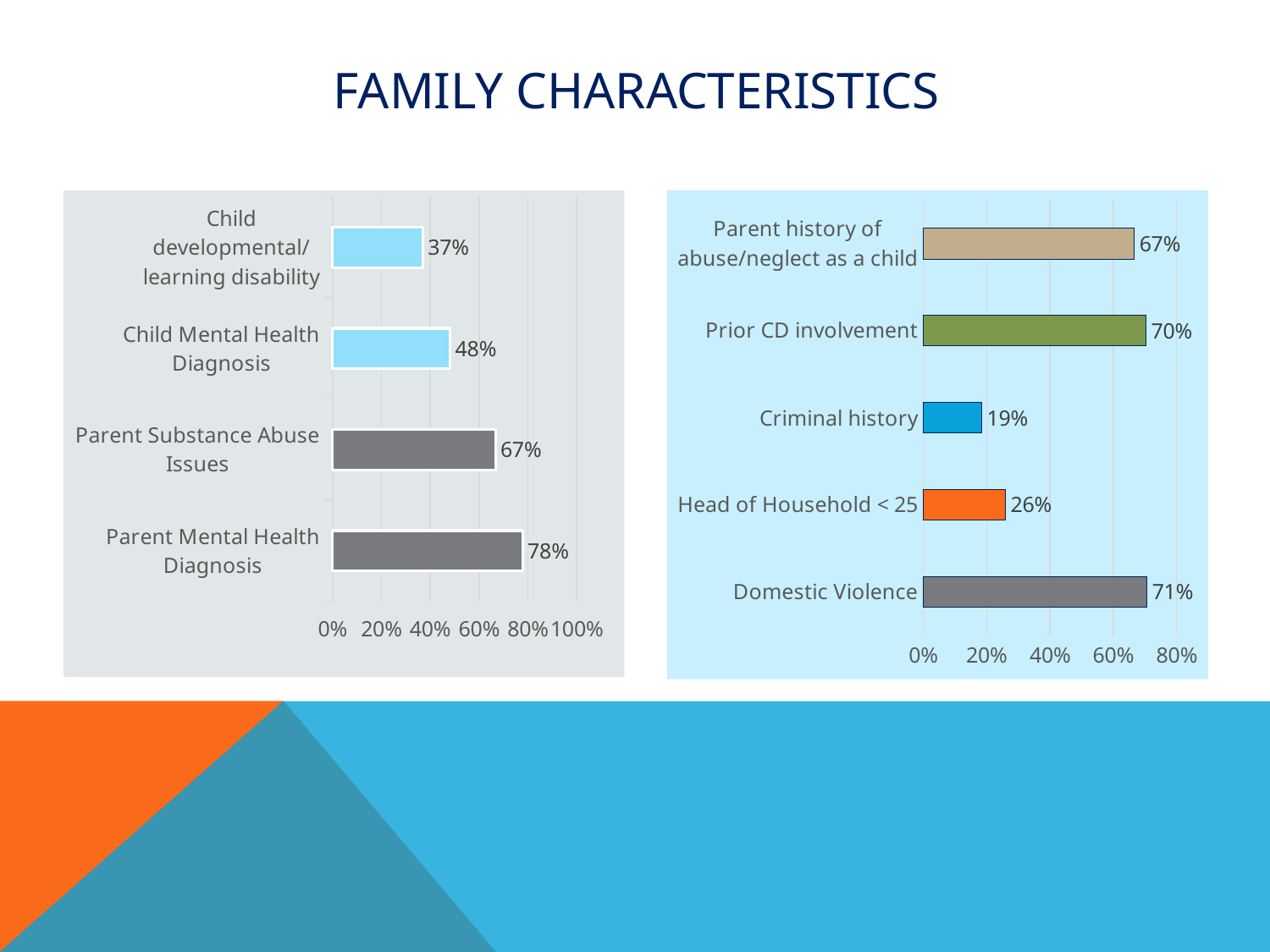
In the right chart, which category has the lowest value? Criminal history In the left chart, which category has the lowest value? Child developmental/learning disability In the left chart, what is the value for Child Mental Health Diagnosis? 48% What kind of chart is the left chart? Bar chart In the left chart, what is the value for Parent Mental Health Diagnosis? 78% In the right chart, which is larger: Prior CD involvement or Parent history of abuse/neglect as a child? Prior CD involvement How many categories does the right chart show? 5 In the right chart, what is the value for Domestic Violence? 71% In the right chart, what is the difference between Head of Household < 25 and Criminal history? 7% In the right chart, what is the value for Criminal history? 19% In the right chart, which category has the highest value? Domestic Violence In the left chart, what is the difference between Parent Mental Health Diagnosis and Parent Substance Abuse Issues? 11%